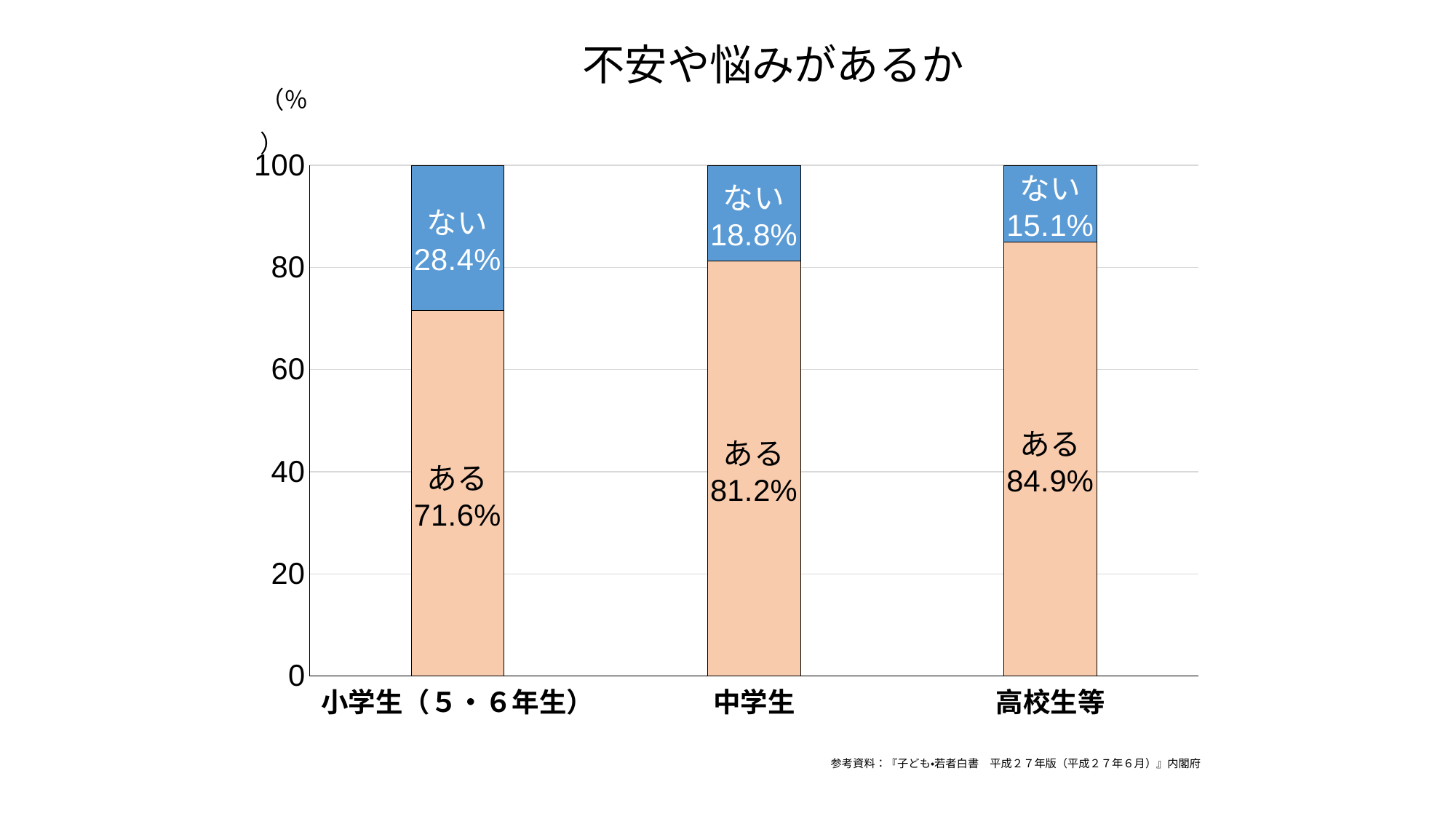
What is the title of the chart? 不安や悩みがあるか What is the value of ない for 高校生等? 15.1% Which category has the lowest value for ない? 高校生等 What is the value of ある for 高校生等? 84.9% Which is larger, the ない value for 中学生 or the ない value for 小学生（5・6年生）? 小学生（5・6年生） Is the ある value for 小学生（5・6年生） greater or less than 80? less What is the value of ない for 小学生（5・6年生）? 28.4% What kind of chart is shown on the slide? Stacked bar chart What is the difference between the ある values for 高校生等 and 小学生（5・6年生）? 13.3% What is the value of ある for 中学生? 81.2% Which category has the highest value for ある? 高校生等 How many categories are shown on the x axis? 3